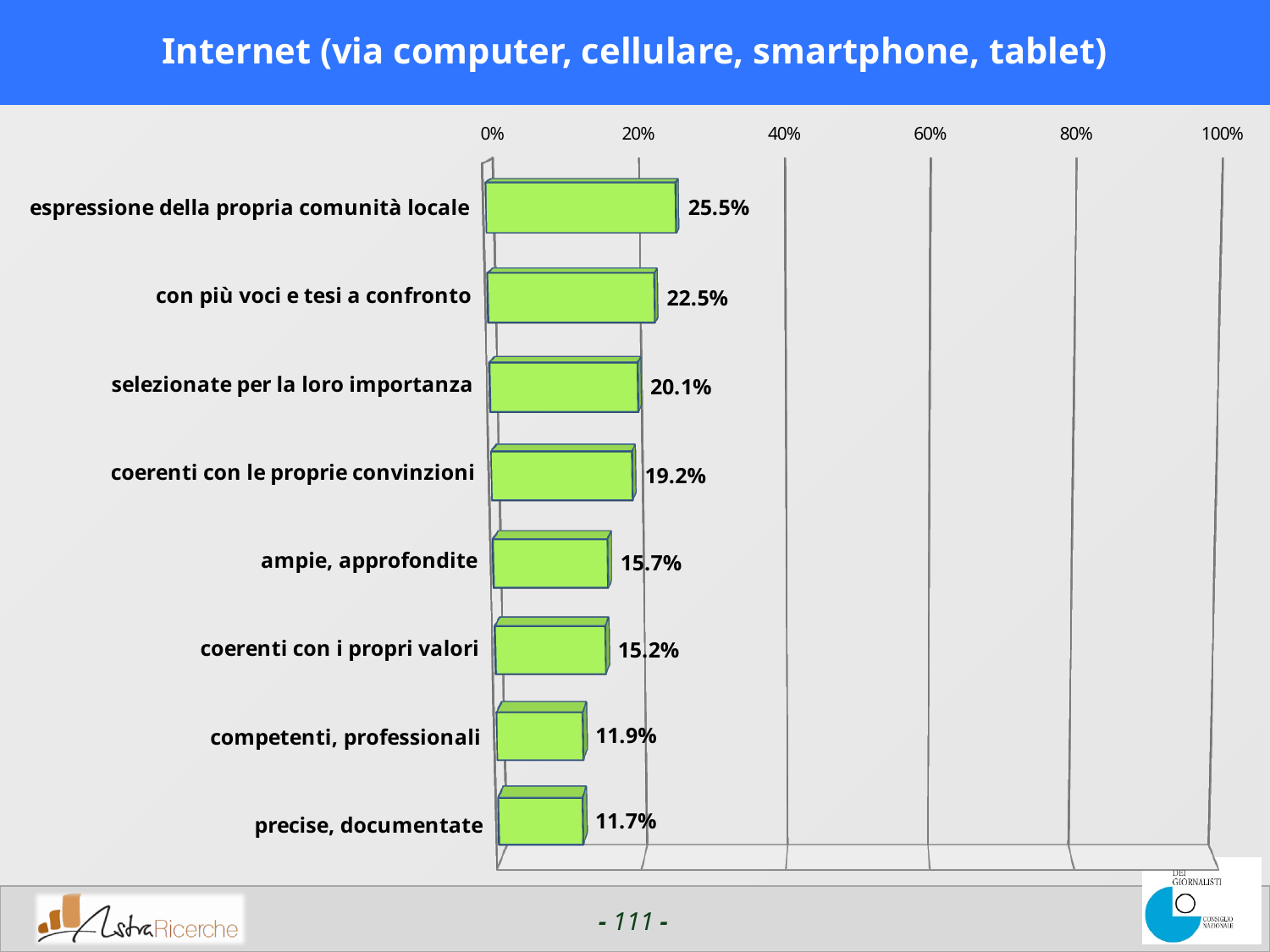
Is the value for "espressione della propria comunità locale" greater or less than 20%? greater What kind of chart is shown on the slide? bar chart Which category has the lowest value? precise, documentate What is the value for "competenti, professionali"? 11.9% What is the maximum value shown on the horizontal axis? 100% What is the value for "ampie, approfondite"? 15.7% Which is larger: "coerenti con le proprie convinzioni" or "coerenti con i propri valori"? coerenti con le proprie convinzioni What is the title of the slide? Internet (via computer, cellulare, smartphone, tablet) How many categories are shown in the chart? 8 What is the value for "espressione della propria comunità locale"? 25.5% Which category has the highest value? espressione della propria comunità locale What is the difference between "con più voci e tesi a confronto" and "selezionate per la loro importanza"? 2.4%